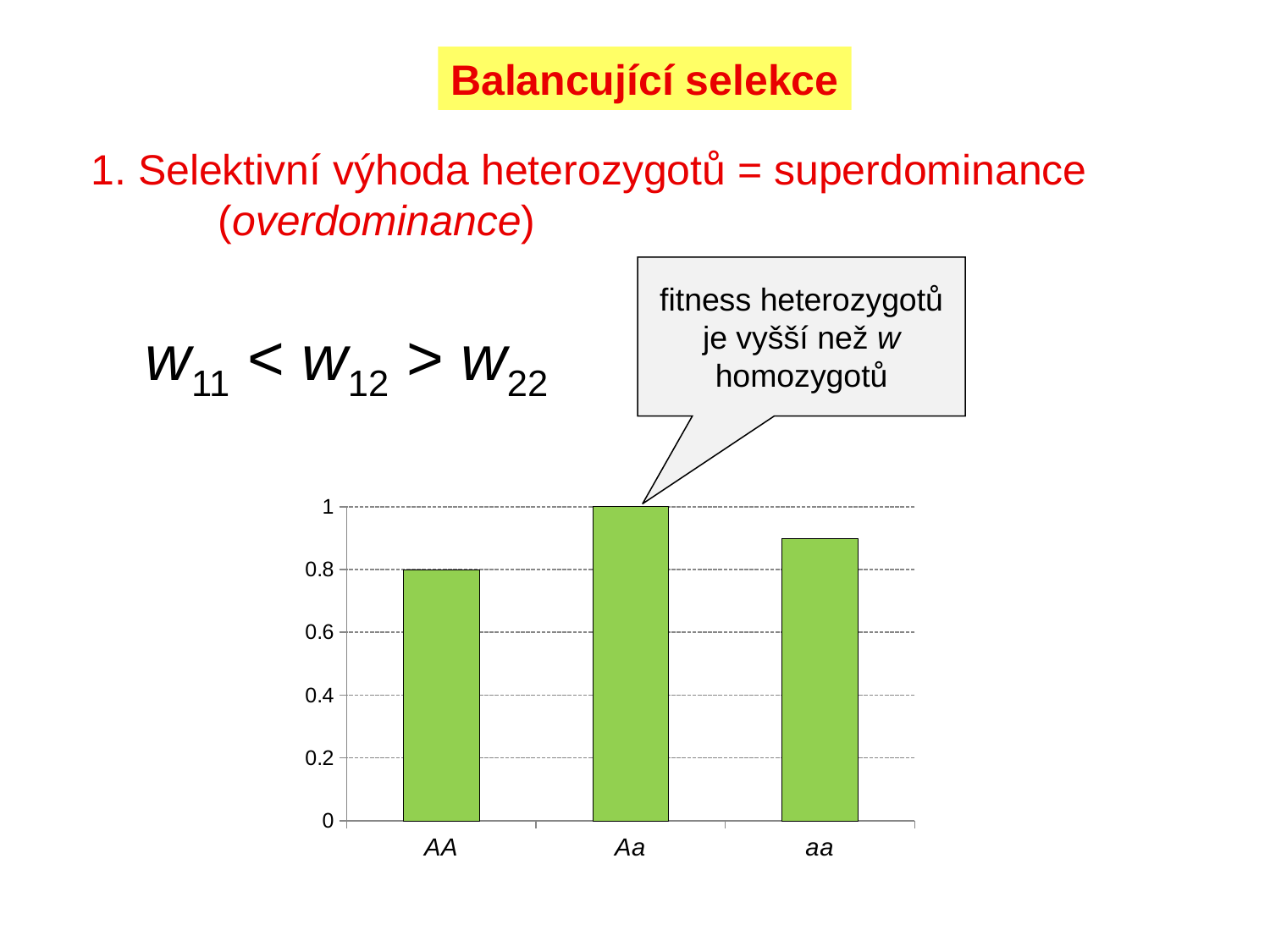
What is the difference between the values for Aa and AA? 0.2 Is the value for aa greater or less than 1? less Which category has the highest bar? Aa What colour are the bars in the chart? green What kind of chart is shown on the slide? bar chart What is the highest value labelled on the y axis? 1 Which category has the lowest bar? AA What is the value for AA? 0.8 Which is larger, the value for AA or the value for aa? aa How many categories are shown on the x axis? 3 Is the value for aa greater or less than 0.8? greater